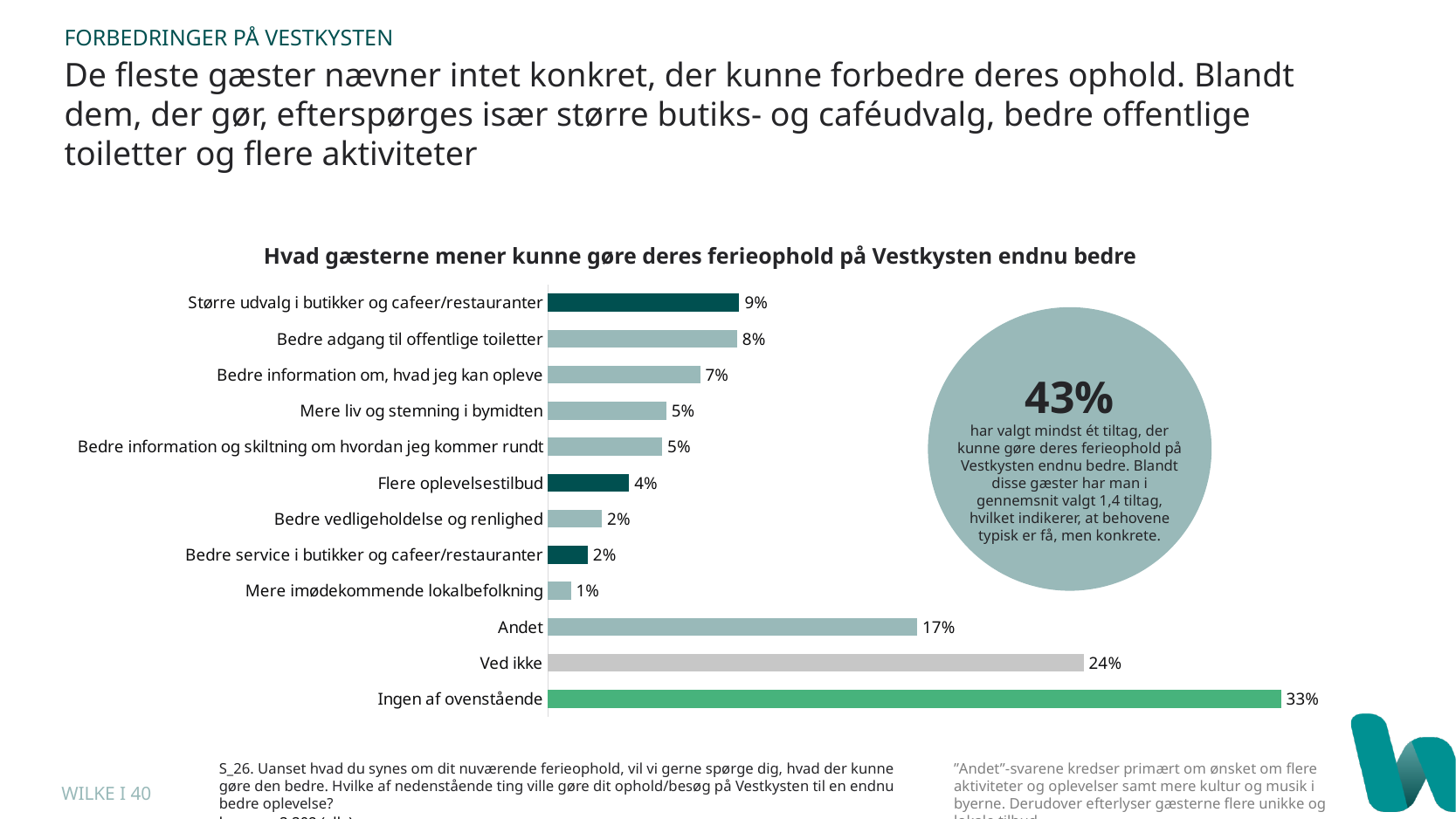
Which category has the lowest value? Mere imødekommende lokalbefolkning What is the difference between "Ved ikke" and "Andet"? 7% Which is larger: "Større udvalg i butikker og cafeer/restauranter" or "Bedre information om, hvad jeg kan opleve"? Større udvalg i butikker og cafeer/restauranter What percentage is shown in the large circle next to the chart? 43% What is the value for "Flere oplevelsestilbud"? 4% What is the value for "Andet"? 17% What kind of chart is shown on the slide? Bar chart What is the value for "Bedre adgang til offentlige toiletter"? 8% What is the difference between "Ingen af ovenstående" and "Ved ikke"? 9% Which category has the highest value? Ingen af ovenstående How many categories are shown in the bar chart? 12 What is the title of the chart? Hvad gæsterne mener kunne gøre deres ferieophold på Vestkysten endnu bedre